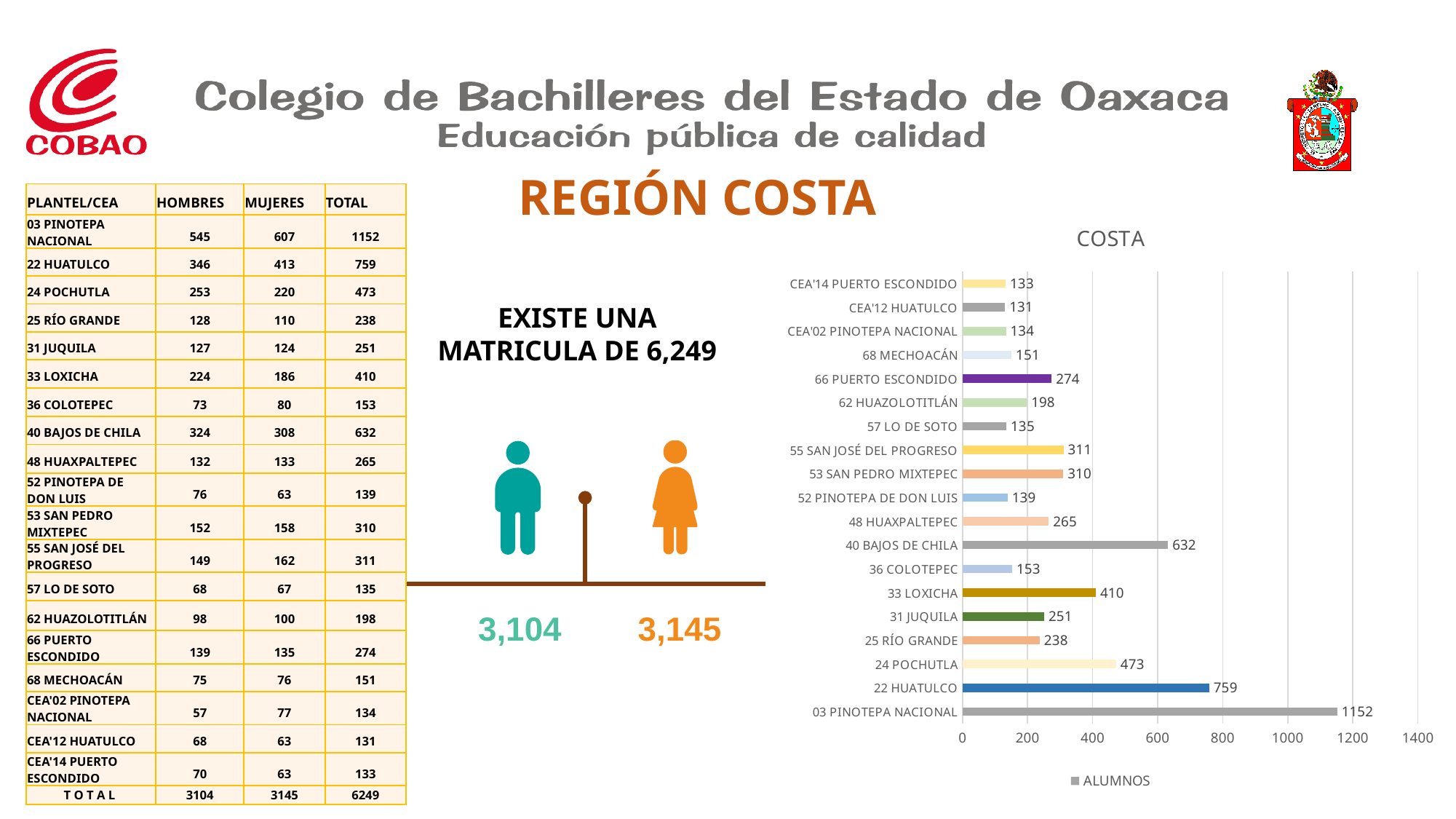
Is the value for 03 PINOTEPA NACIONAL in the COSTA chart greater or less than 1000? greater How many series does the legend of the COSTA chart list? 1 Which is larger in the COSTA chart, 33 LOXICHA or 31 JUQUILA? 33 LOXICHA Which category has the highest value in the COSTA chart? 03 PINOTEPA NACIONAL What kind of chart is the COSTA chart? bar chart Which category has the lowest value in the COSTA chart? CEA'12 HUATULCO What is the difference between the values for 22 HUATULCO and 24 POCHUTLA in the COSTA chart? 286 What is the value for 40 BAJOS DE CHILA in the COSTA chart? 632 How many categories are shown in the COSTA chart? 19 What is the value for CEA'12 HUATULCO in the COSTA chart? 131 What is the legend entry of the COSTA chart? ALUMNOS What is the value for 62 HUAZOLOTITLÁN in the COSTA chart? 198